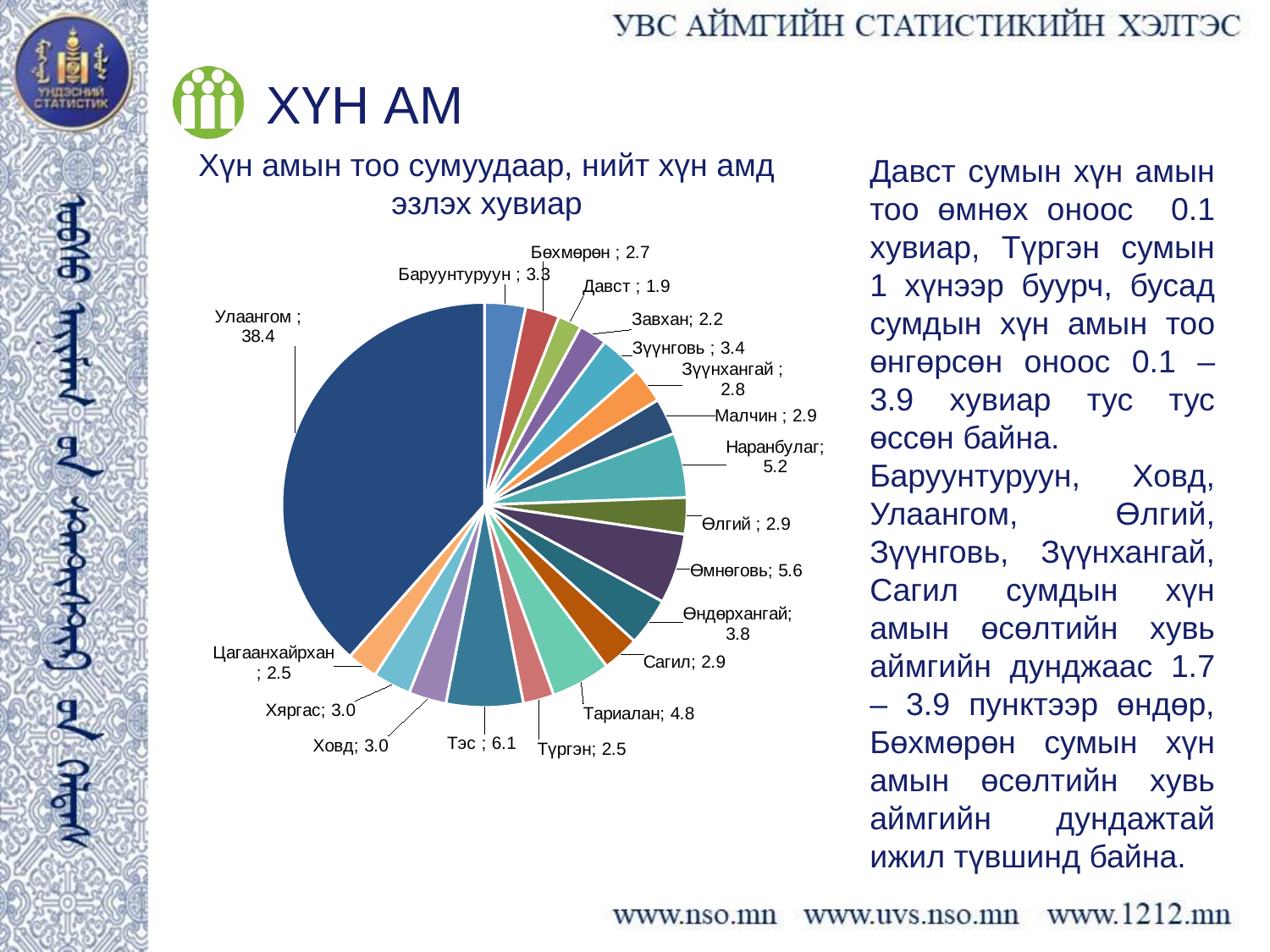
What is the difference between the values for Улаангом and Тэс? 32.3 What is the difference between the values for Тэс and Өмнөговь? 0.5 What is the value shown for Улаангом? 38.4 What is the value shown for Наранбулаг? 5.2 Which sum has the smallest slice of the pie? Давст What is the title of the pie chart? Хүн амын тоо сумуудаар, нийт хүн амд эзлэх хувиар What kind of chart is shown on the slide? pie chart How many slices does the pie chart have? 19 What is the value shown for Тэс? 6.1 What is the value shown for Давст? 1.9 Which sum has the largest slice of the pie? Улаангом Which is larger, the value for Тариалан or the value for Өндөрхангай? Тариалан